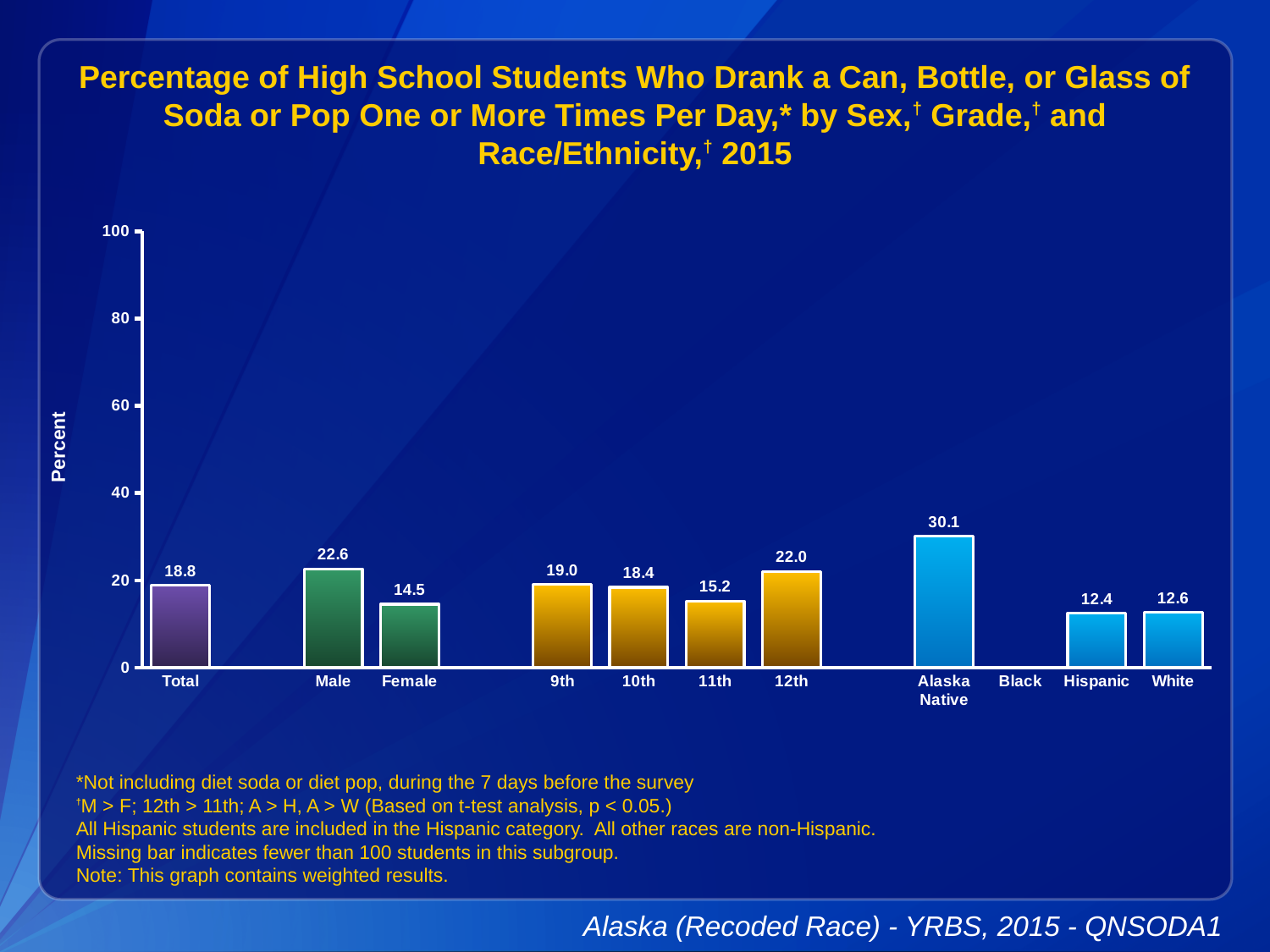
Which is larger, the value for 12th grade or the value for 9th grade? 12th What is the difference between the Male and Female values? 8.1 Which race/ethnicity category has no bar shown? Black Which category has the highest value? Alaska Native What kind of chart is shown on the slide? bar chart Is the value for Alaska Native greater or less than 20? greater What is the value for Alaska Native? 30.1 What is the value for Male? 22.6 Which category has the lowest value among the bars shown? Hispanic How many bars are plotted on the chart? 11 What is the value for Total? 18.8 What is the value for 11th grade? 15.2